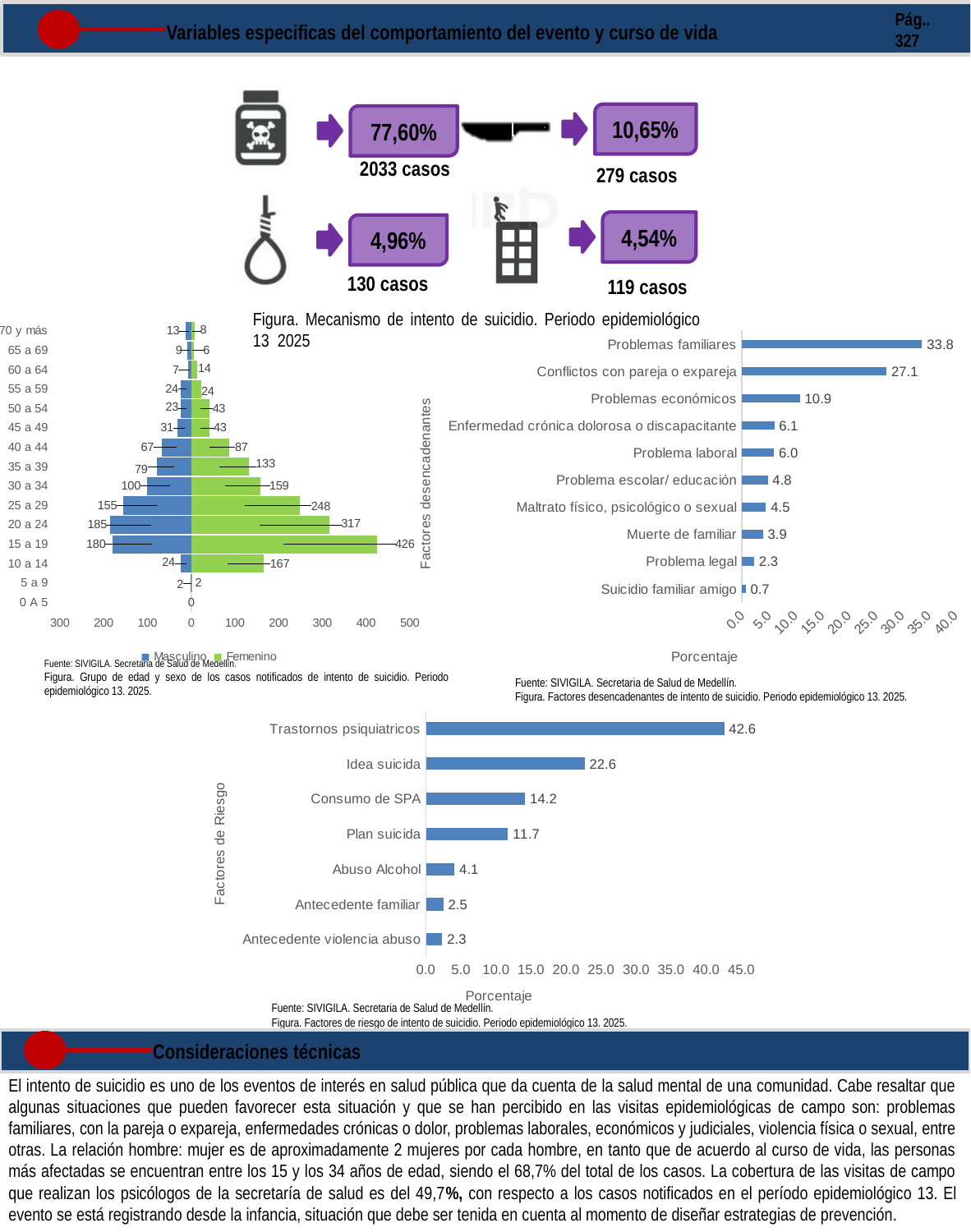
In the 'Factores de Riesgo' chart, which factor has the highest value? Trastornos psiquiatricos In the age and sex pyramid chart, what is the Femenino value for the 15 a 19 age group? 426 In the 'Factores desencadenantes' chart, what is the value for Problemas familiares? 33.8 In the age and sex pyramid chart, what is the Masculino value for the 20 a 24 age group? 185 In the 'Factores desencadenantes' chart, which factor has the lowest value? Suicidio familiar amigo In the 'Factores de Riesgo' chart, is the value for Consumo de SPA greater or less than 15.0? less How many series does the legend of the age and sex pyramid chart list? 2 In the age and sex pyramid chart, which is larger for the 25 a 29 age group, Masculino or Femenino? Femenino In the 'Factores de Riesgo' chart, what is the value for Idea suicida? 22.6 How many categories are shown in the 'Factores de Riesgo' chart? 7 How many categories are shown in the 'Factores desencadenantes' chart? 10 In the 'Factores desencadenantes' chart, what is the difference between Problemas familiares and Conflictos con pareja o expareja? 6.7